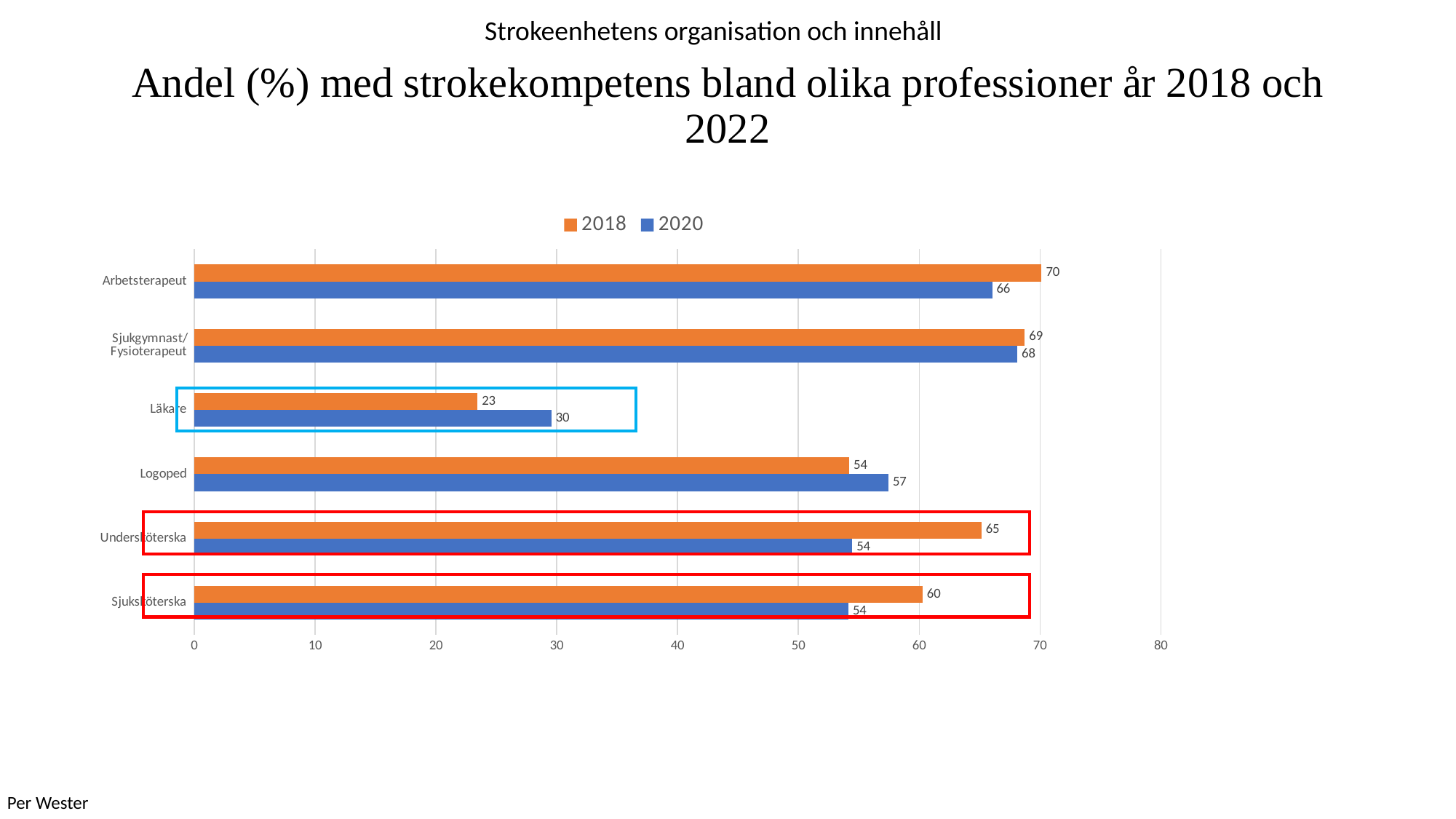
What is the difference between the 2018 and 2020 values for Undersköterska? 11 What is the 2020 value for Läkare? 30 Is the 2018 value for Sjuksköterska greater or less than 50? greater Which profession has the highest 2018 value? Arbetsterapeut What is the 2020 value for Logoped? 57 Which profession has the lowest 2020 value? Läkare How many professions are shown on the chart? 6 How many series does the legend list? 2 Which colour represents the 2020 series in the legend? blue What is the 2018 value for Arbetsterapeut? 70 What kind of chart is shown on the slide? bar chart Which is larger for Läkare, the 2018 value or the 2020 value? 2020